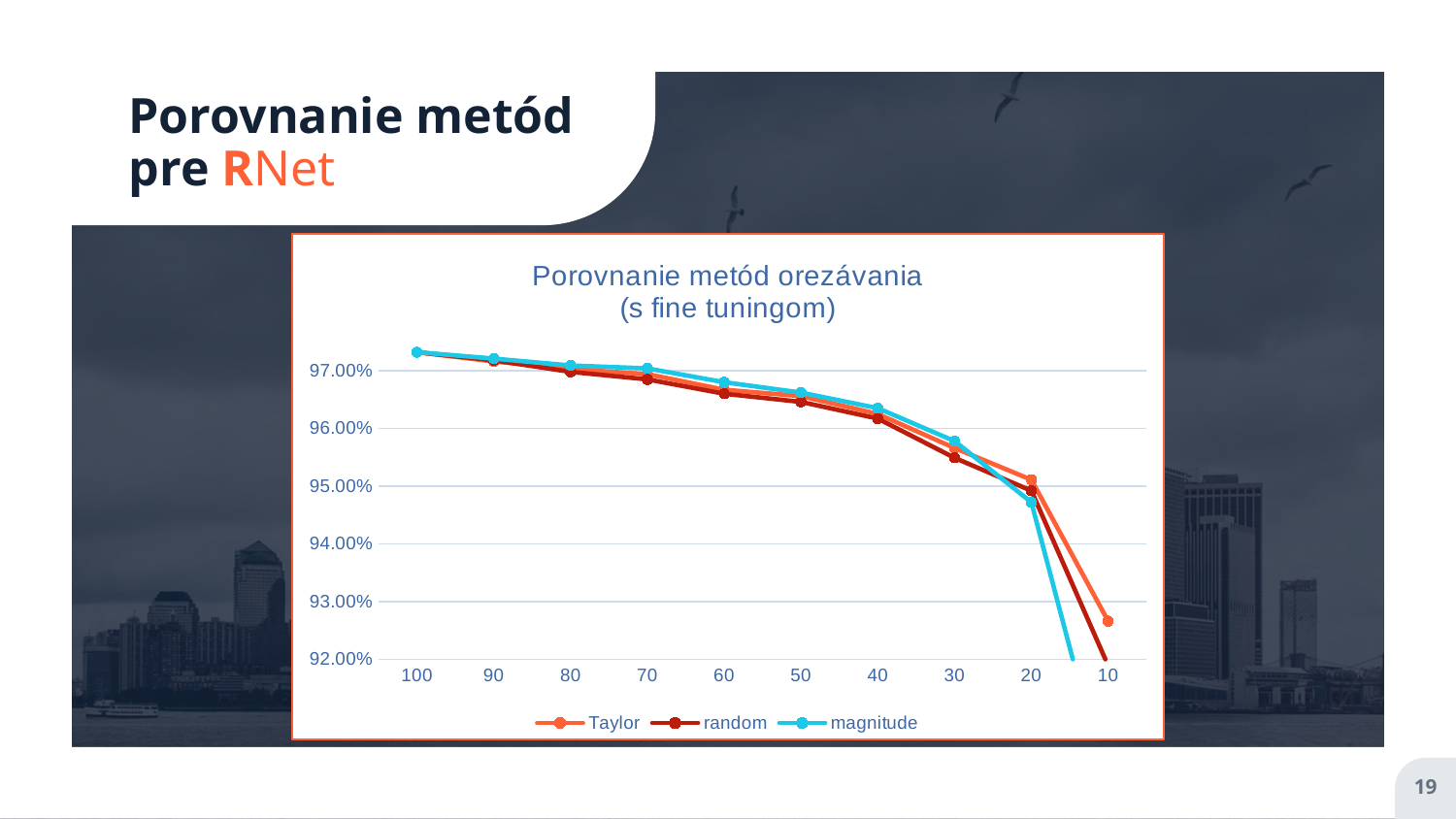
Which series has the lowest value at 20? magnitude What is the title of the chart? Porovnanie metód orezávania (s fine tuningom) Is the value for Taylor at 10 greater or less than 93.00%? less How many series does the legend list? 3 Is the value for Taylor at 100 greater or less than 97.00%? greater Do the values rise or fall as the x axis goes from 100 to 10? fall At 10, which is larger, the value for Taylor or the value for random? Taylor What kind of chart is shown on the slide? line chart Is the value for magnitude at 20 greater or less than 95.00%? less How many points are labelled on the x axis? 10 Which series is drawn in light blue? magnitude